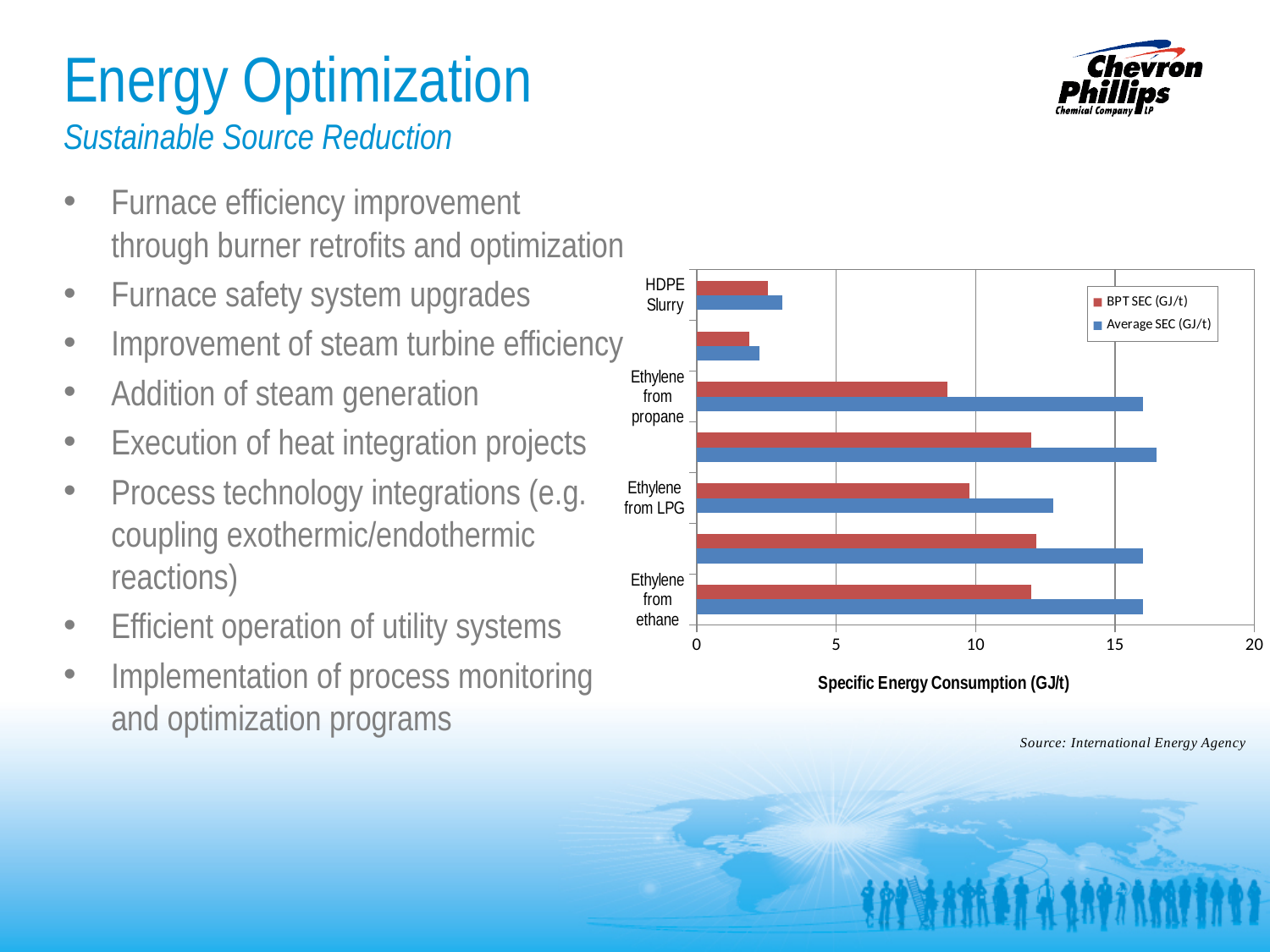
What kind of chart is shown on the slide? bar chart Which labeled category has the lowest Average SEC (GJ/t)? HDPE Slurry What is the title of the chart's horizontal axis? Specific Energy Consumption (GJ/t) Is the Average SEC (GJ/t) value for Ethylene from propane greater or less than 15? greater For Ethylene from ethane, which is larger: the BPT SEC (GJ/t) or the Average SEC (GJ/t)? Average SEC (GJ/t) What are the two series named in the chart legend? BPT SEC (GJ/t) and Average SEC (GJ/t) How many series does the chart legend list? 2 Is the BPT SEC (GJ/t) value for HDPE Slurry greater or less than 5? less Is the BPT SEC (GJ/t) value for Ethylene from ethane greater or less than 10? greater Which has the larger Average SEC (GJ/t): Ethylene from LPG or Ethylene from ethane? Ethylene from ethane